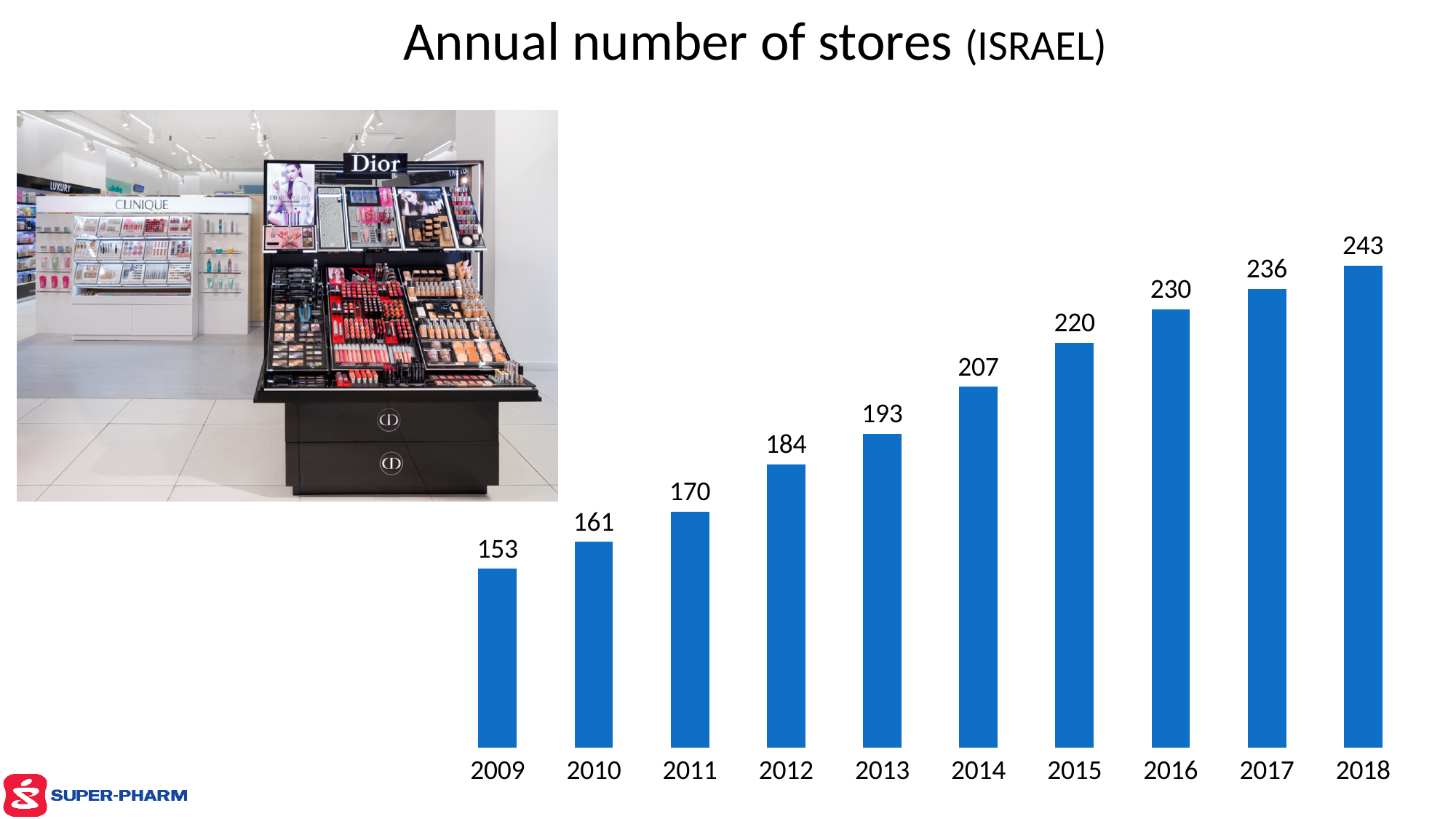
What is the difference in the number of stores between 2013 and 2012? 9 Does the number of stores rise or fall from 2009 to 2018? Rise What kind of chart is shown on the slide? Bar chart What is the title of the chart? Annual number of stores (ISRAEL) Which year has more stores, 2011 or 2015? 2015 Which year has the lowest number of stores? 2009 Which year has the highest number of stores? 2018 What is the number of stores in 2014? 207 What is the number of stores in 2018? 243 How many years are shown in the chart? 10 What is the difference in the number of stores between 2018 and 2009? 90 What is the number of stores in 2009? 153